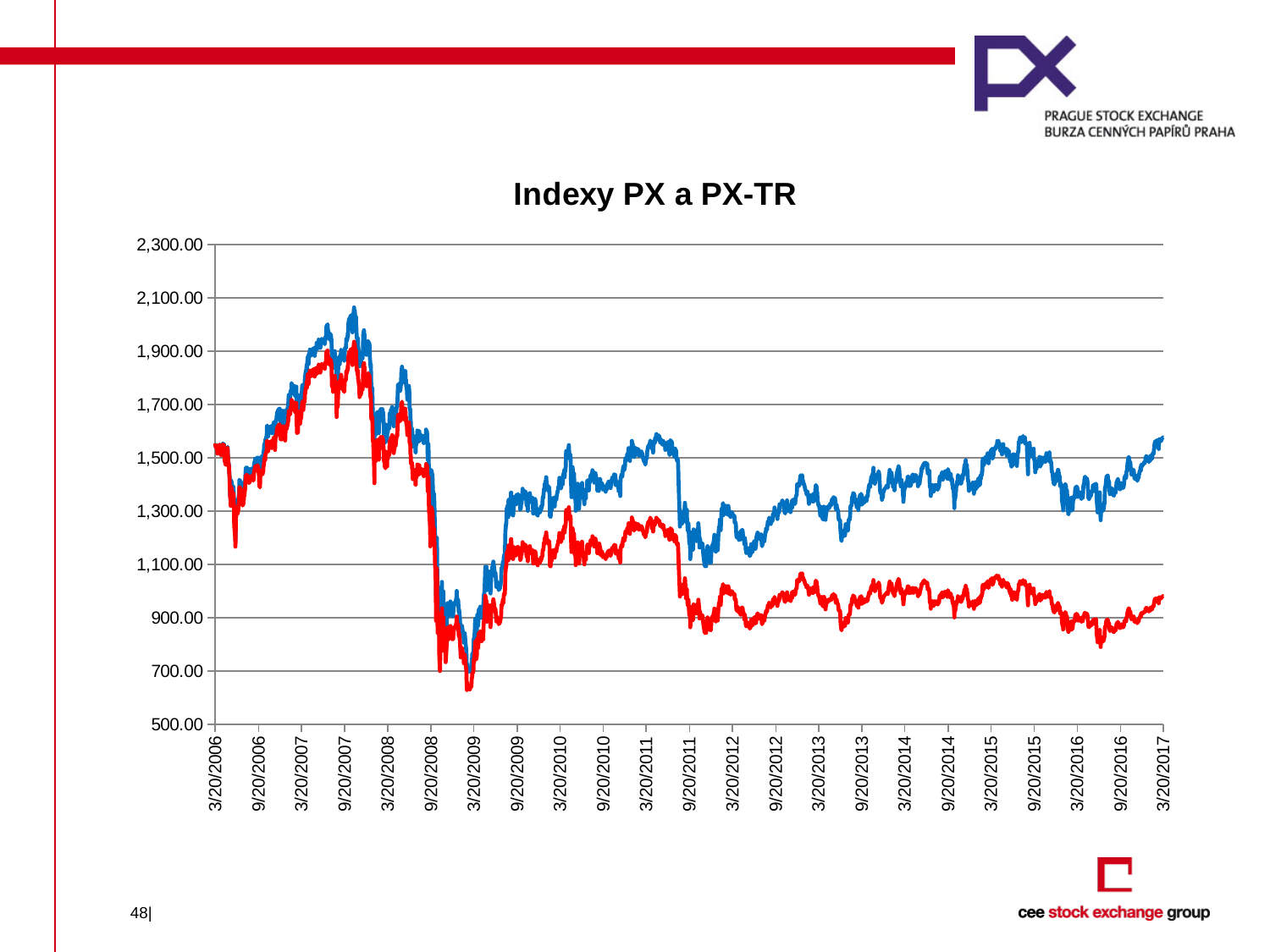
At 3/20/2017, which line is higher, the blue line or the red line? the blue line Between 9/20/2007 and 3/20/2009, does the blue line rise or fall? fall What is the highest value shown on the y axis? 2,300.00 Is the value of the red line at 3/20/2009 greater or less than 900? less How many date labels are shown on the x axis? 23 What kind of chart is shown on the slide? line chart What is the title of the chart? Indexy PX a PX-TR Is the peak of the blue line around 9/20/2007 greater or less than 1,900? greater Is the value of the red line at 3/20/2017 greater or less than 1,100? less How many lines are plotted on the chart? 2